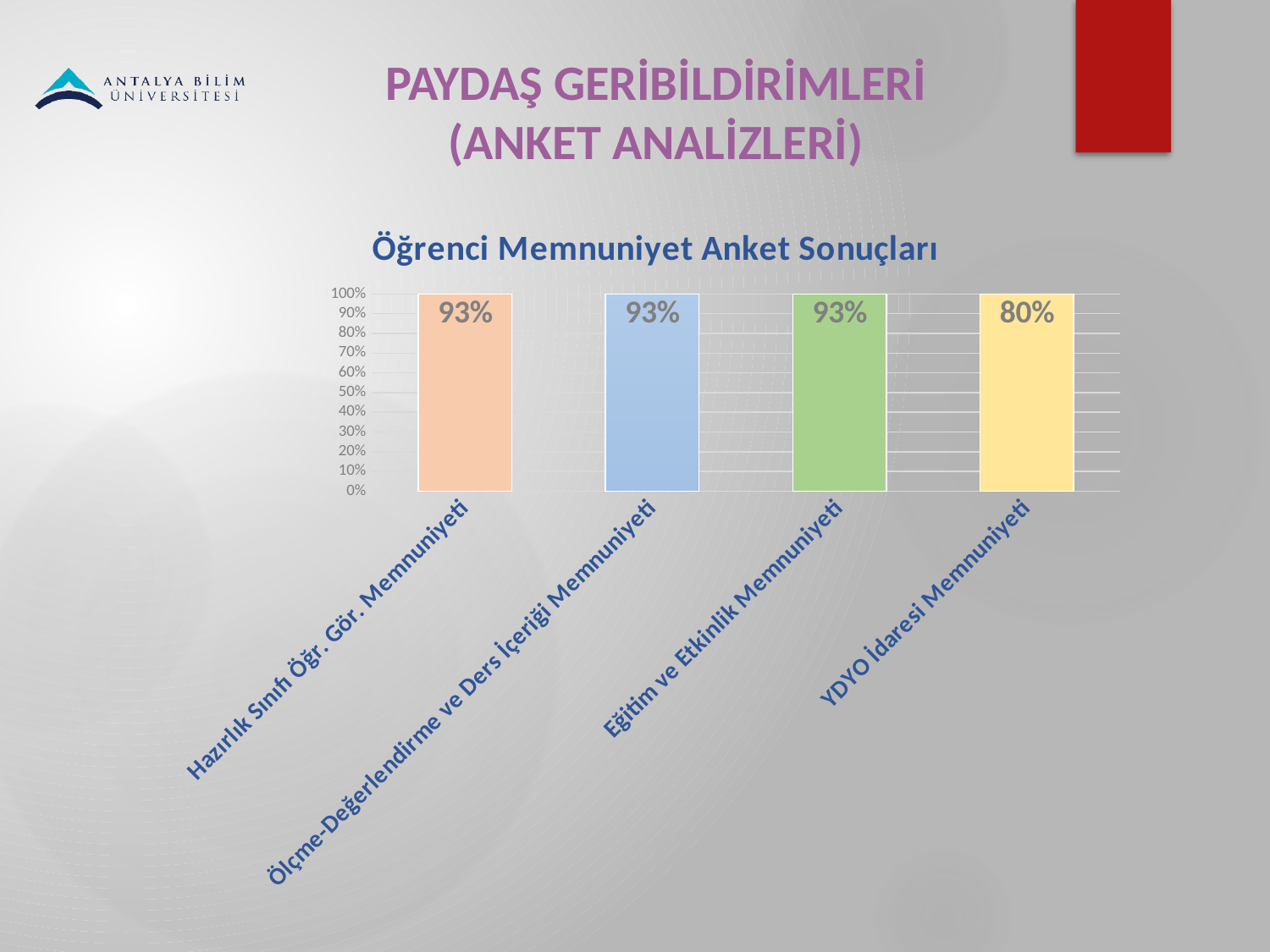
What is the title of the chart? Öğrenci Memnuniyet Anket Sonuçları What is the value for Eğitim ve Etkinlik Memnuniyeti? 93% What is the value for Ölçme-Değerlendirme ve Ders İçeriği Memnuniyeti? 93% What colour is the bar for YDYO İdaresi Memnuniyeti? yellow What kind of chart is shown on the slide? bar chart What is the value for Hazırlık Sınıfı Öğr. Gör. Memnuniyeti? 93% Is the value for YDYO İdaresi Memnuniyeti greater or less than 50%? greater What is the value for YDYO İdaresi Memnuniyeti? 80% Which is larger, the value for Hazırlık Sınıfı Öğr. Gör. Memnuniyeti or the value for YDYO İdaresi Memnuniyeti? Hazırlık Sınıfı Öğr. Gör. Memnuniyeti How many categories are shown in the chart? 4 Which category has the lowest value? YDYO İdaresi Memnuniyeti What is the difference between the values for Eğitim ve Etkinlik Memnuniyeti and YDYO İdaresi Memnuniyeti? 13%